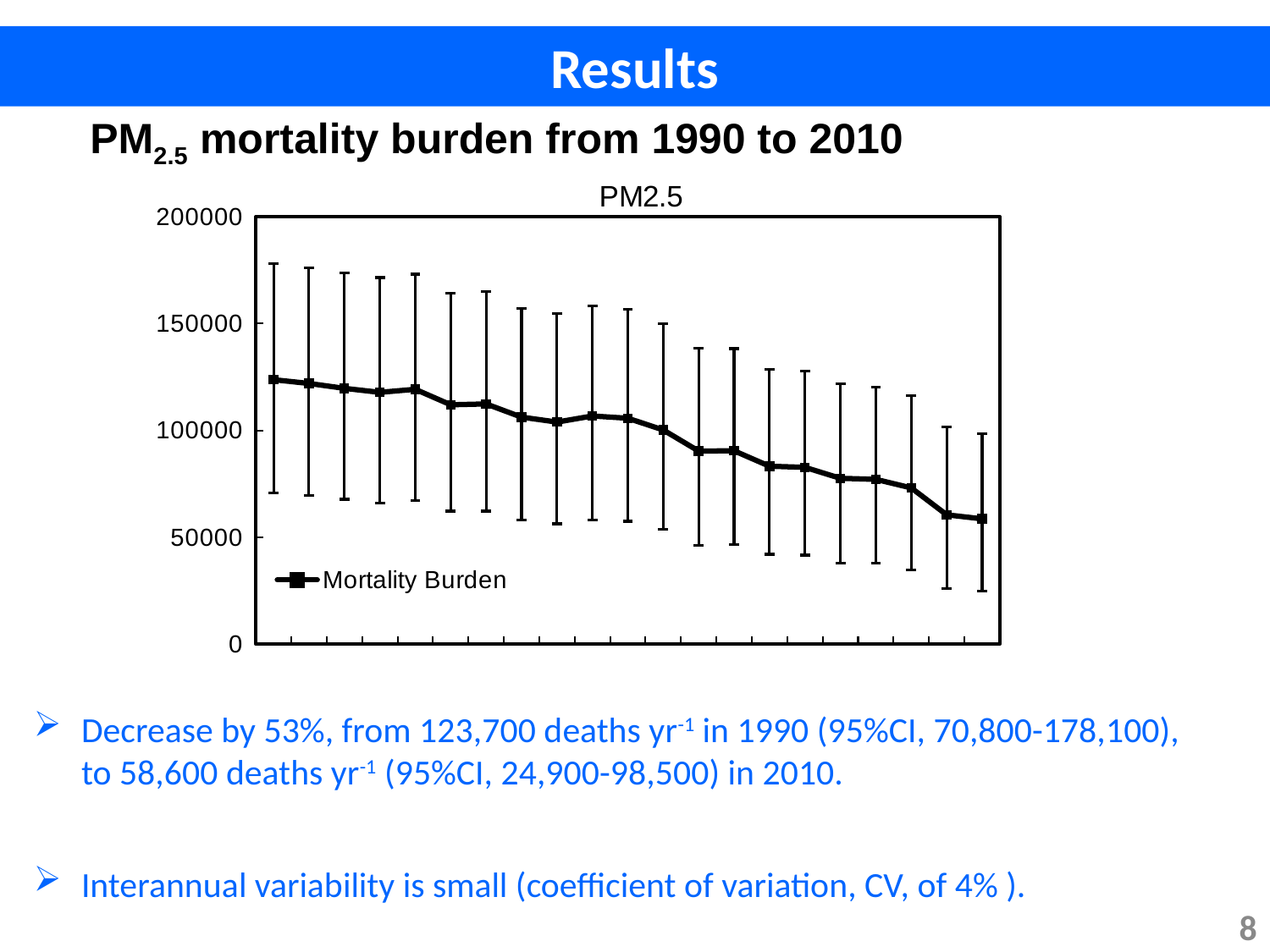
Do the values rise or fall along the x axis from 1990 to 2010? fall How many data points are plotted on the Mortality Burden line? 21 What kind of chart is shown on the slide? line chart Is the Mortality Burden value for the first point (1990) greater or less than 150000? less Is the Mortality Burden value for the last point (2010) greater or less than 100000? less Which has the larger Mortality Burden value, the first point (1990) or the last point (2010)? 1990 Is the Mortality Burden value for the middle point (2000) greater or less than 150000? less What is the name of the series shown in the legend? Mortality Burden What is the title printed above the chart? PM2.5 How many series does the legend list? 1